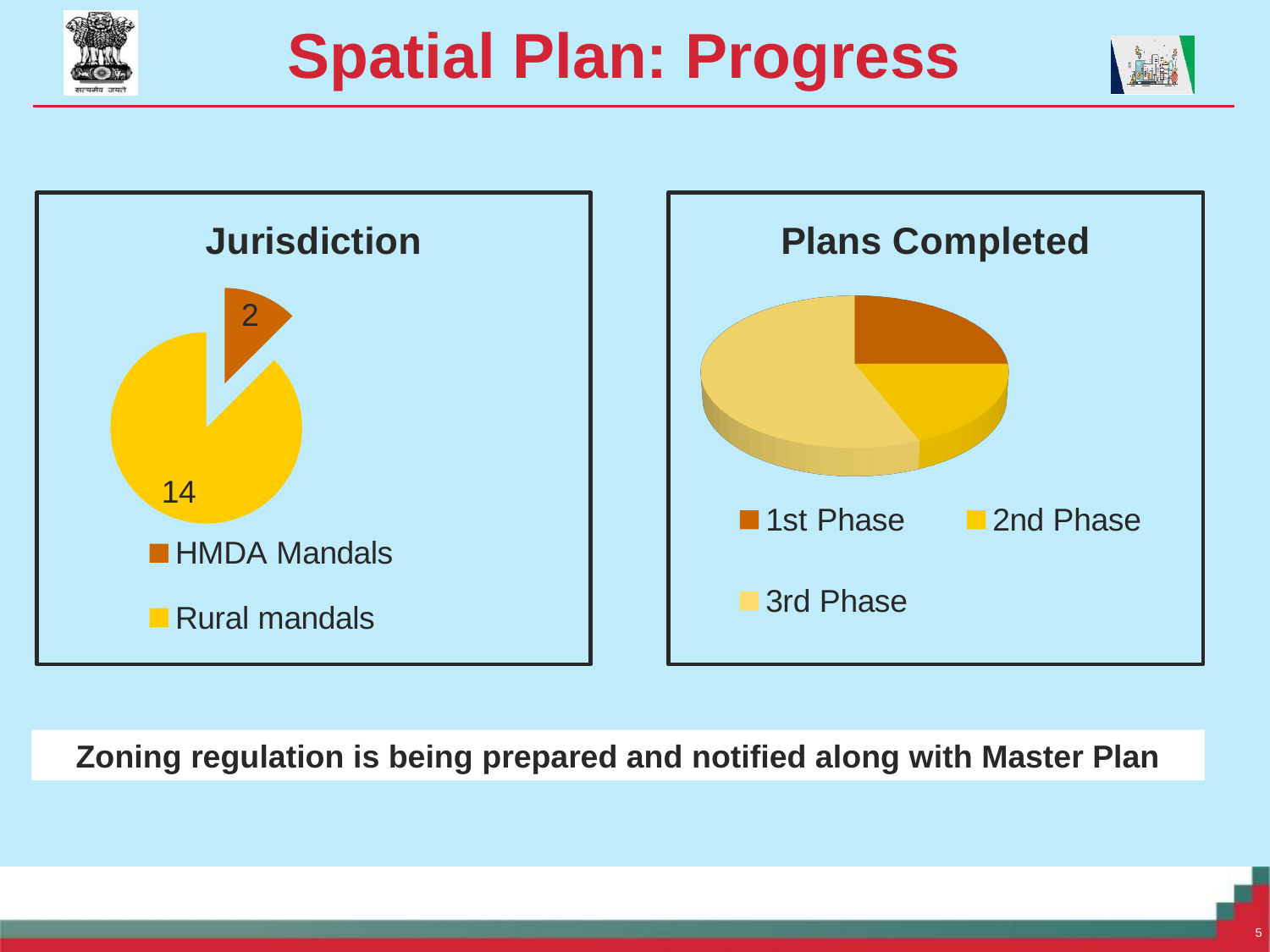
In the Jurisdiction chart, which category has the largest slice? Rural mandals In the Plans Completed chart, which slice is larger, 1st Phase or 3rd Phase? 3rd Phase In the Jurisdiction chart, what is the value for Rural mandals? 14 In the Jurisdiction chart, what share of the pie do Rural mandals represent? 87.5% What kind of chart is the Plans Completed chart? Pie chart In the Jurisdiction chart, what is the difference between Rural mandals and HMDA Mandals? 12 In the Jurisdiction chart, which category has the smallest slice? HMDA Mandals In the Jurisdiction chart, what is the value for HMDA Mandals? 2 How many entries does the legend of the Plans Completed chart list? 3 How many categories does the Jurisdiction chart show? 2 In the Plans Completed chart, which phase has the largest slice? 3rd Phase In the Jurisdiction chart, what is the total of the two slices? 16